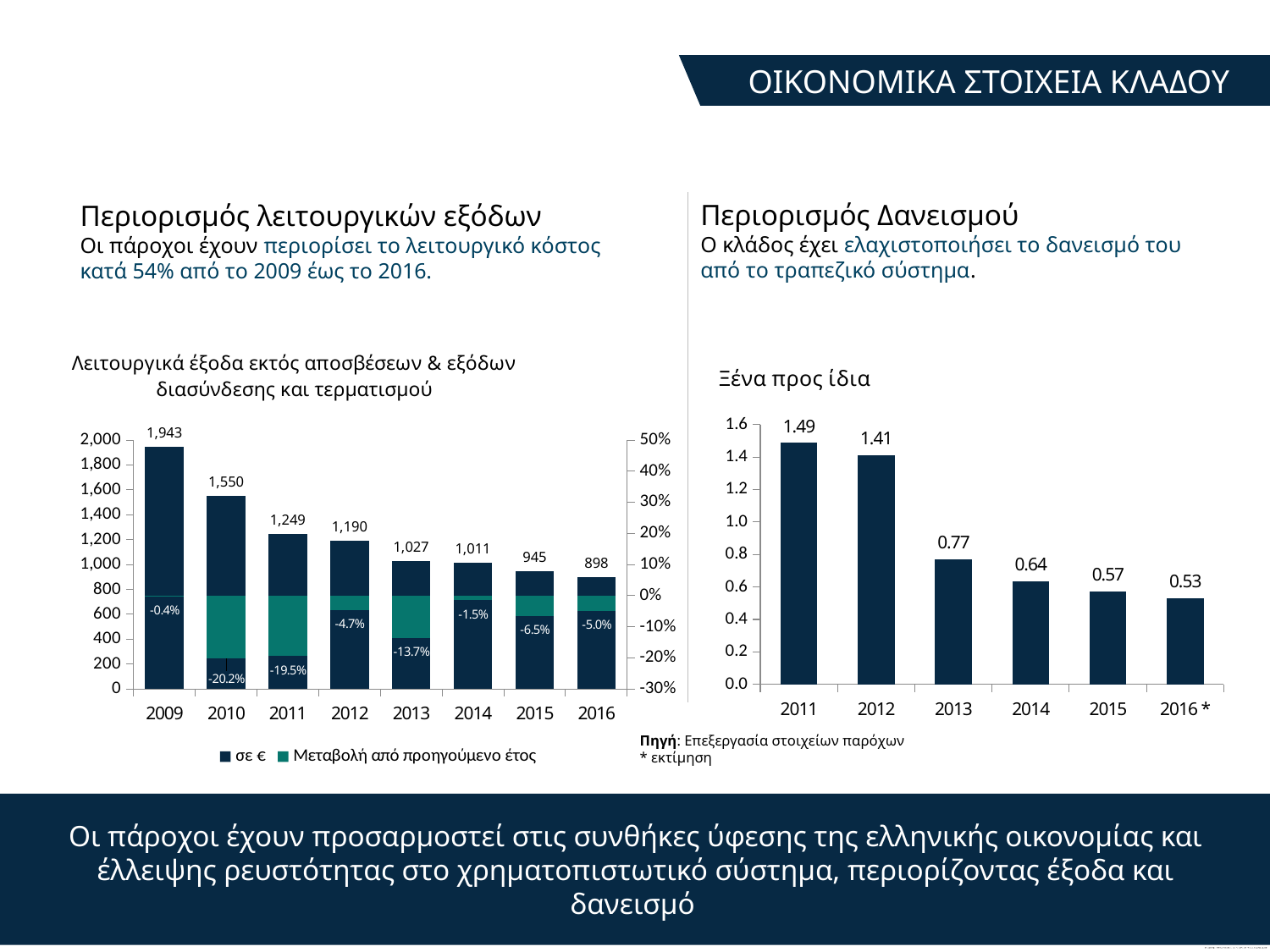
In the right chart (Ξένα προς ίδια), how many years are shown on the x axis? 6 In the left chart (Λειτουργικά έξοδα), what is the change from the previous year shown for 2010? -20.2% In the left chart (Λειτουργικά έξοδα), how many series does the legend list? 2 In the left chart (Λειτουργικά έξοδα), do the values in € rise or fall from 2009 to 2016? fall In the left chart (Λειτουργικά έξοδα), which year has the highest value in €? 2009 In the right chart (Ξένα προς ίδια), what is the value for 2013? 0.77 In the left chart (Λειτουργικά έξοδα εκτός αποσβέσεων & εξόδων διασύνδεσης και τερματισμού), what is the value in € for 2009? 1,943 In the left chart (Λειτουργικά έξοδα), what is the value in € for 2016? 898 What kind of chart is the right chart (Ξένα προς ίδια)? bar chart In the right chart (Ξένα προς ίδια), which year has the lowest value? 2016* In the right chart (Ξένα προς ίδια), what is the difference between the 2011 and 2012 values? 0.08 In the left chart (Λειτουργικά έξοδα), what is the difference in € between 2009 and 2010? 393